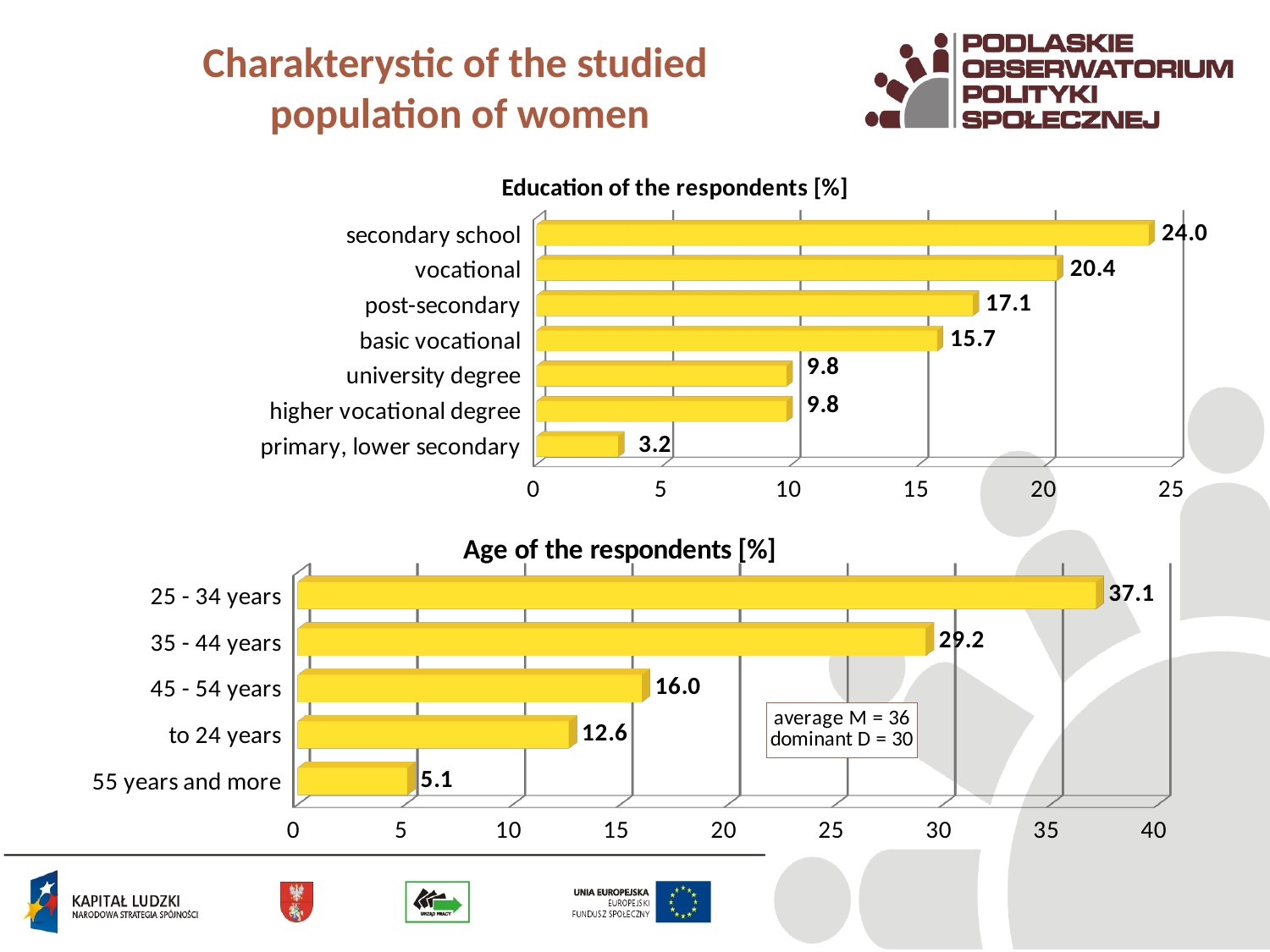
What kind of chart is the 'Age of the respondents [%]' chart? bar chart In the 'Education of the respondents [%]' chart, what is the value for post-secondary? 17.1 In the 'Education of the respondents [%]' chart, which category has the lowest value? primary, lower secondary In the 'Age of the respondents [%]' chart, what is the value for 55 years and more? 5.1 In the 'Age of the respondents [%]' chart, what average M value is stated in the text box? 36 In the 'Education of the respondents [%]' chart, how many categories are shown? 7 In the 'Age of the respondents [%]' chart, which is larger: 45 - 54 years or to 24 years? 45 - 54 years In the 'Age of the respondents [%]' chart, how many age groups are shown? 5 In the 'Age of the respondents [%]' chart, what is the difference between 25 - 34 years and 35 - 44 years? 7.9 In the 'Education of the respondents [%]' chart, what is the difference between vocational and basic vocational? 4.7 In the 'Age of the respondents [%]' chart, which age group has the highest value? 25 - 34 years In the 'Education of the respondents [%]' chart, what is the value for secondary school? 24.0